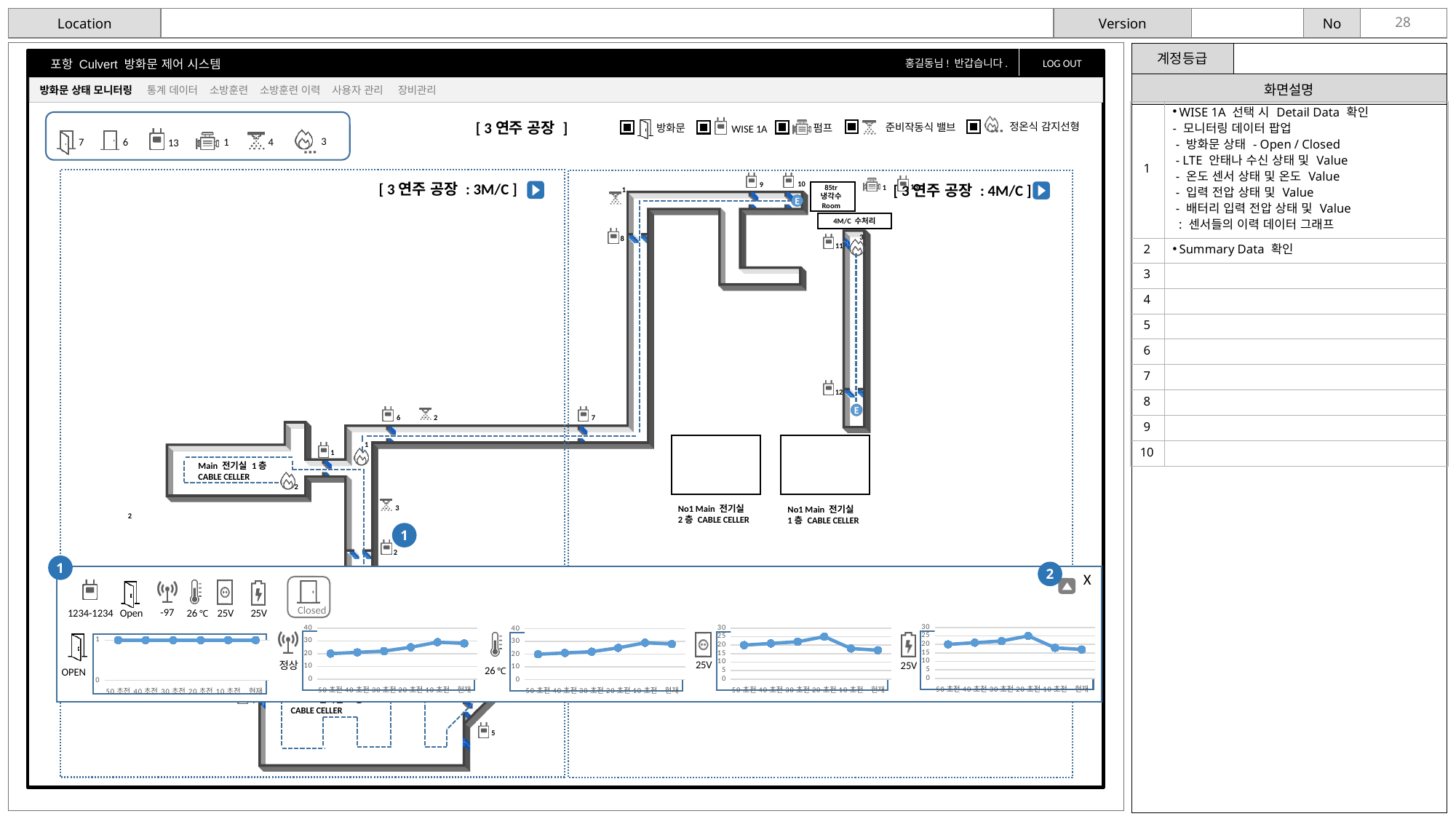
In the second chart from the left in the bottom panel (next to 정상), is the value at 50 초전 greater or less than 30? less In the middle chart of the bottom panel (next to 26 ℃), is the value at 현재 greater or less than 20? greater In the fourth chart from the left in the bottom panel (next to 25V), is the value at 현재 greater or less than 20? less What is the highest y-axis tick shown on the second chart from the left in the bottom panel (next to 정상)? 40 How many small charts are shown in the bottom detail panel? 5 What is the label of the last x-axis category in the rightmost chart of the bottom panel? 현재 In the second chart from the left in the bottom panel (next to 정상), do the values generally rise or fall from 50 초전 to 현재? rise In the leftmost chart of the bottom panel (next to OPEN), do the values rise, fall, or stay flat from 50 초전 to 현재? stay flat In the middle chart of the bottom panel (next to 26 ℃), how many time points are plotted along the x axis? 6 In the middle chart of the bottom panel (next to 26 ℃), do the values generally rise or fall from 50 초전 to 현재? rise What kind of chart is the second chart from the left in the bottom panel (next to the 정상 label)? line chart